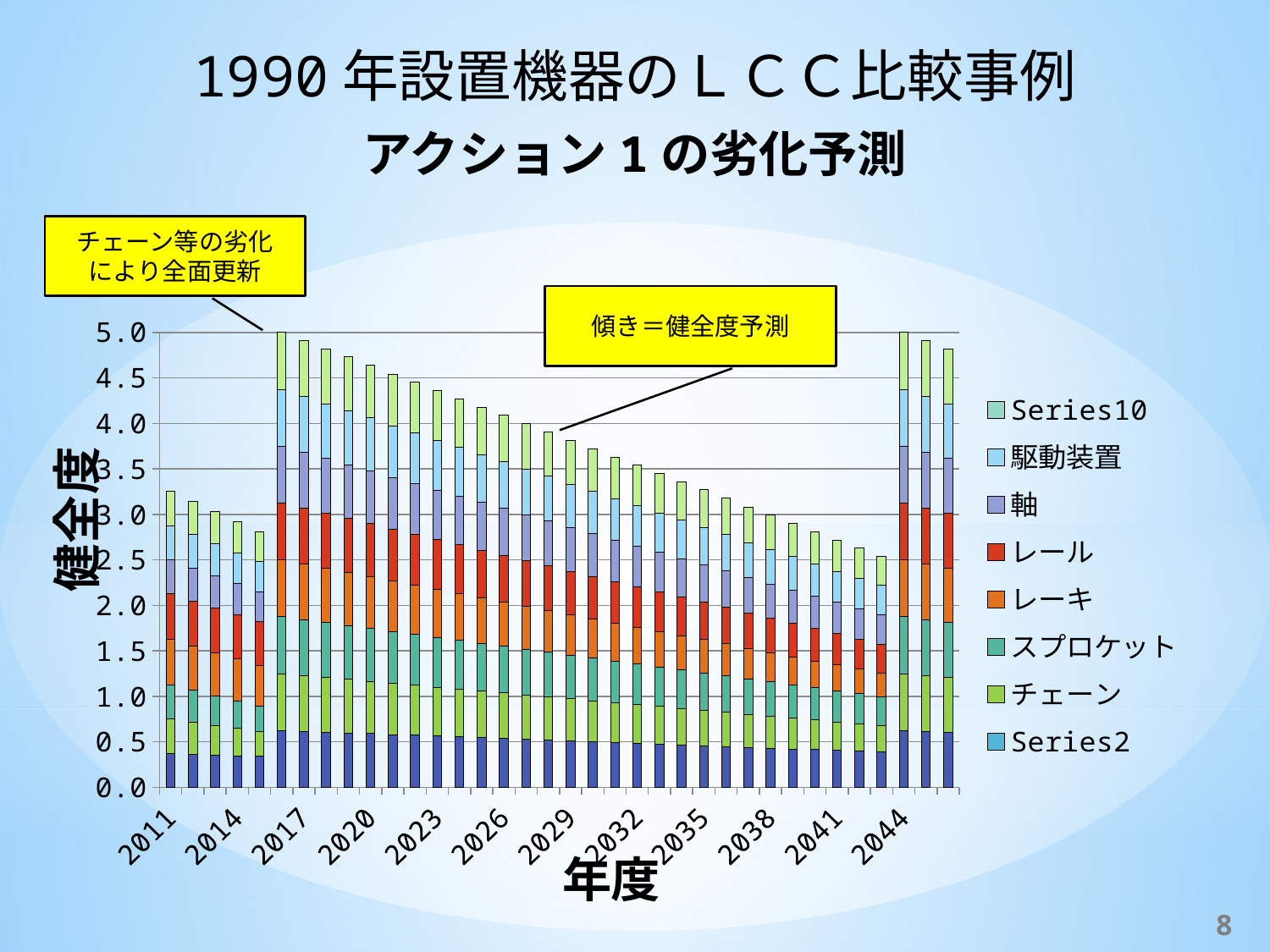
Which stacked bar is taller, the one for 2011 or the one for 2014? 2011 Is the total value of the stacked bar for 2041 greater or less than 3.0? less What kind of chart is shown on the slide? Stacked bar chart Is the total value of the stacked bar for 2029 greater or less than 4.0? less What is the title of the vertical axis of the chart? 健全度 Is the total value of the stacked bar for 2011 greater or less than 3.0? greater Which stacked bar is taller, the one for 2017 or the one for 2044? 2044 How many series does the chart legend list? 8 What is the title of the horizontal axis of the chart? 年度